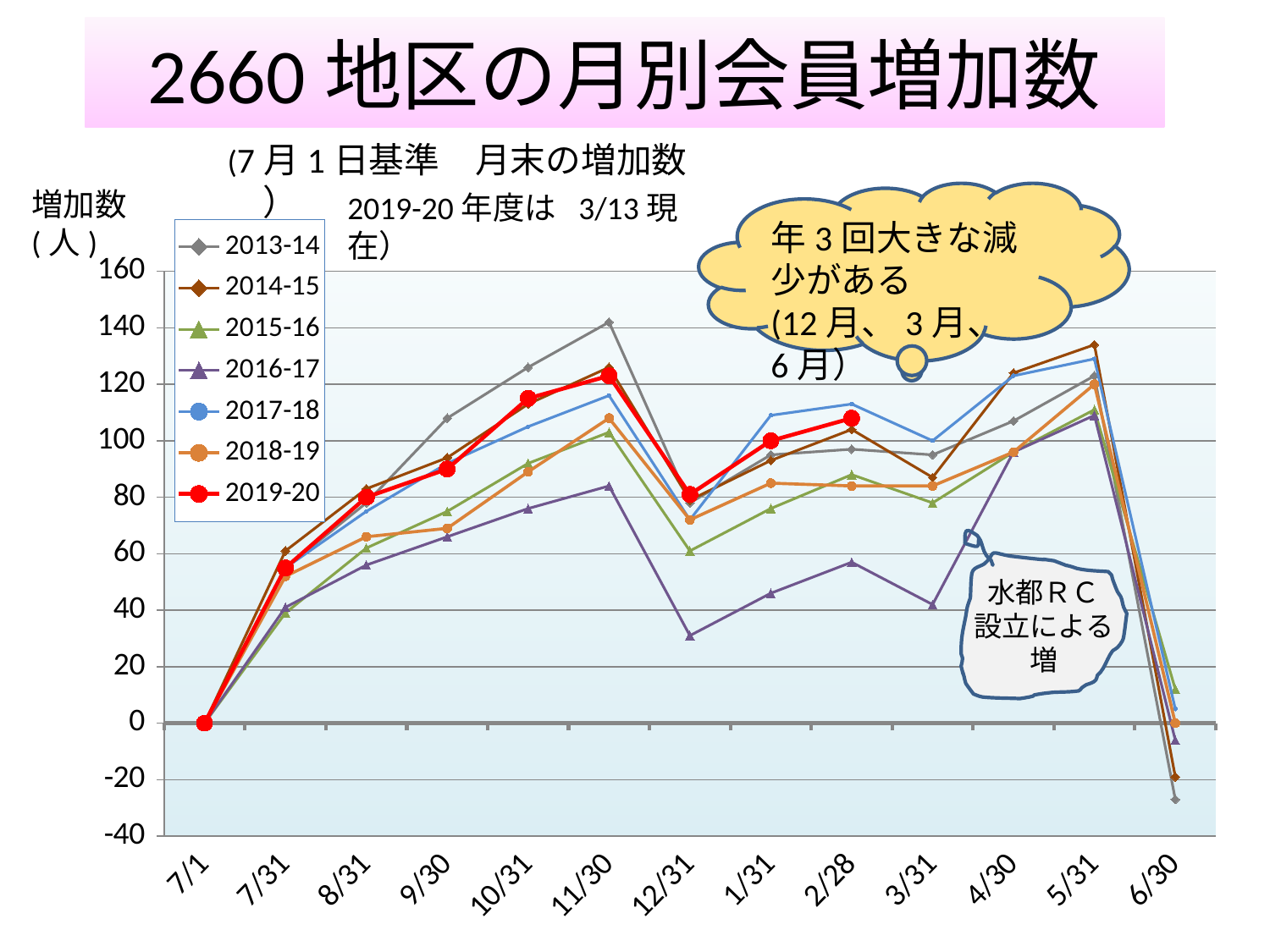
Which series has the lowest value at 12/31? 2016-17 What kind of chart is shown on the slide? line chart Which series has the highest value at 11/30? 2013-14 How many date categories are shown on the x axis? 13 For the 2019-20 series, which is larger: the value at 11/30 or the value at 12/31? 11/30 Is the value for the 2016-17 series at 12/31 greater or less than 40? less Does the 2019-20 series rise or fall from 7/1 to 11/30? rise How many series does the legend list? 7 Which series has the lowest value at 6/30? 2013-14 Is the value for the 2013-14 series at 11/30 greater or less than 120? greater Is the value for the 2013-14 series at 6/30 greater or less than 0? less What is the value for the 2019-20 series at 7/1? 0